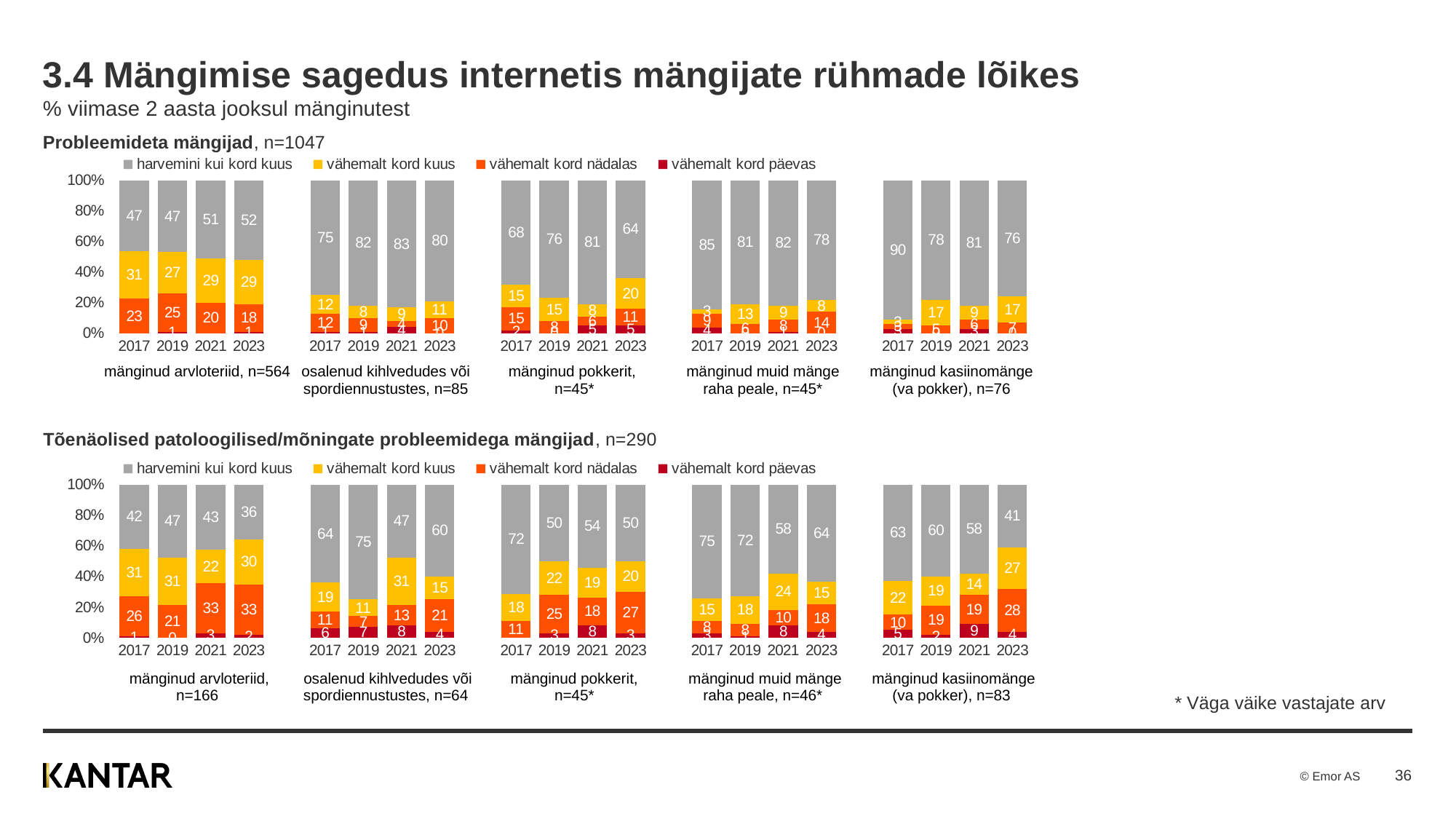
What kind of chart is used on this slide? Stacked bar chart In the bottom chart, what is the 'vähemalt kord kuus' value for osalenud kihlvedudes või spordiennustustes in 2021? 31 In the top chart (Probleemideta mängijad), what percentage of those who played arvloteriid in 2023 played 'harvemini kui kord kuus'? 52 How many year categories are shown for each player group in the charts? 4 How many series does the legend of the top chart list? 4 In the bottom chart, for mänginud arvloteriid, which year has the lowest 'harvemini kui kord kuus' value? 2023 In the bottom chart, is the 'vähemalt kord nädalas' value for mänginud pokkerit larger in 2019 or in 2017? 2019 In the top chart, what is the 'harvemini kui kord kuus' value for mänginud kasiinomänge (va pokker) in 2017? 90 In the bottom chart, how does the 'harvemini kui kord kuus' value for mänginud kasiinomänge (va pokker) change from 2017 to 2023? It falls (63 to 41) In the top chart, for mänginud pokkerit, which year has the highest 'vähemalt kord kuus' value? 2023 In the bottom chart (Tõenäolised patoloogilised/mõningate probleemidega mängijad), what is the 'vähemalt kord nädalas' value for mänginud kasiinomänge (va pokker) in 2023? 28 In the top chart, what is the difference between the 'harvemini kui kord kuus' values for osalenud kihlvedudes või spordiennustustes in 2021 and 2017? 8